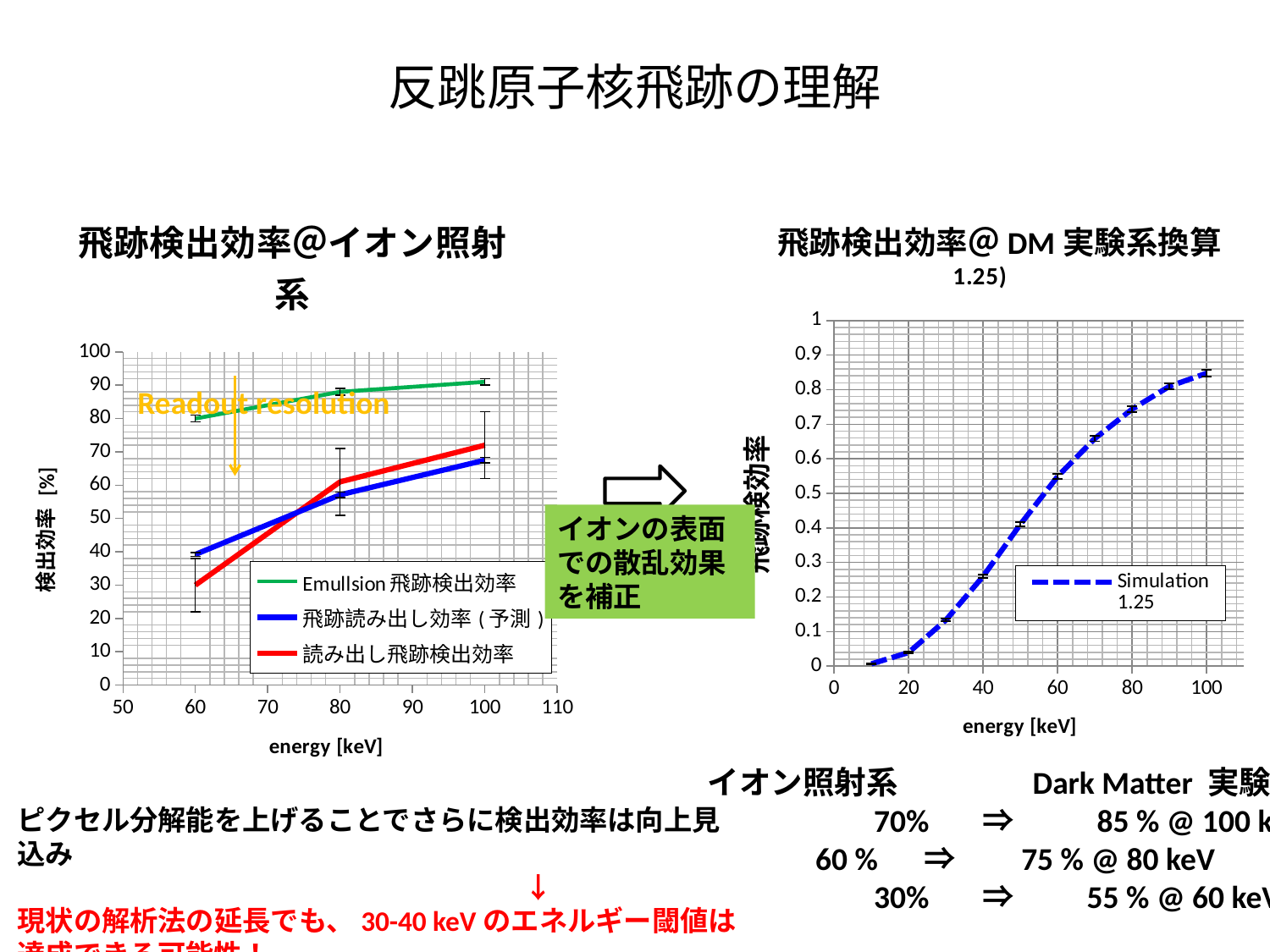
In the left chart (飛跡検出効率@イオン照射系), is the value of Emullsion飛跡検出効率 at 60 keV greater or less than 70? greater How many series does the legend of the left chart (飛跡検出効率@イオン照射系) list? 3 In the left chart (飛跡検出効率@イオン照射系), at how many energy values is each series plotted? 3 What kind of chart is the left chart titled 飛跡検出効率@イオン照射系? line chart In the left chart (飛跡検出効率@イオン照射系), which is larger at 100 keV: 読み出し飛跡検出効率 or 飛跡読み出し効率(予測)? 読み出し飛跡検出効率 In the right chart (飛跡検出効率@ DM実験系換算), is the Simulation 1.25 value at 80 keV greater or less than 0.7? greater In the right chart (飛跡検出効率@ DM実験系換算), is the Simulation 1.25 value at 40 keV greater or less than 0.3? less In the left chart (飛跡検出効率@イオン照射系), which series has the highest value at 60 keV? Emullsion飛跡検出効率 In the right chart (飛跡検出効率@ DM実験系換算), does the Simulation 1.25 value rise or fall as energy increases? rise In the left chart (飛跡検出効率@イオン照射系), which series has the lowest value at 60 keV? 読み出し飛跡検出効率 What is the name of the series shown in the legend of the right chart (飛跡検出効率@ DM実験系換算)? Simulation 1.25